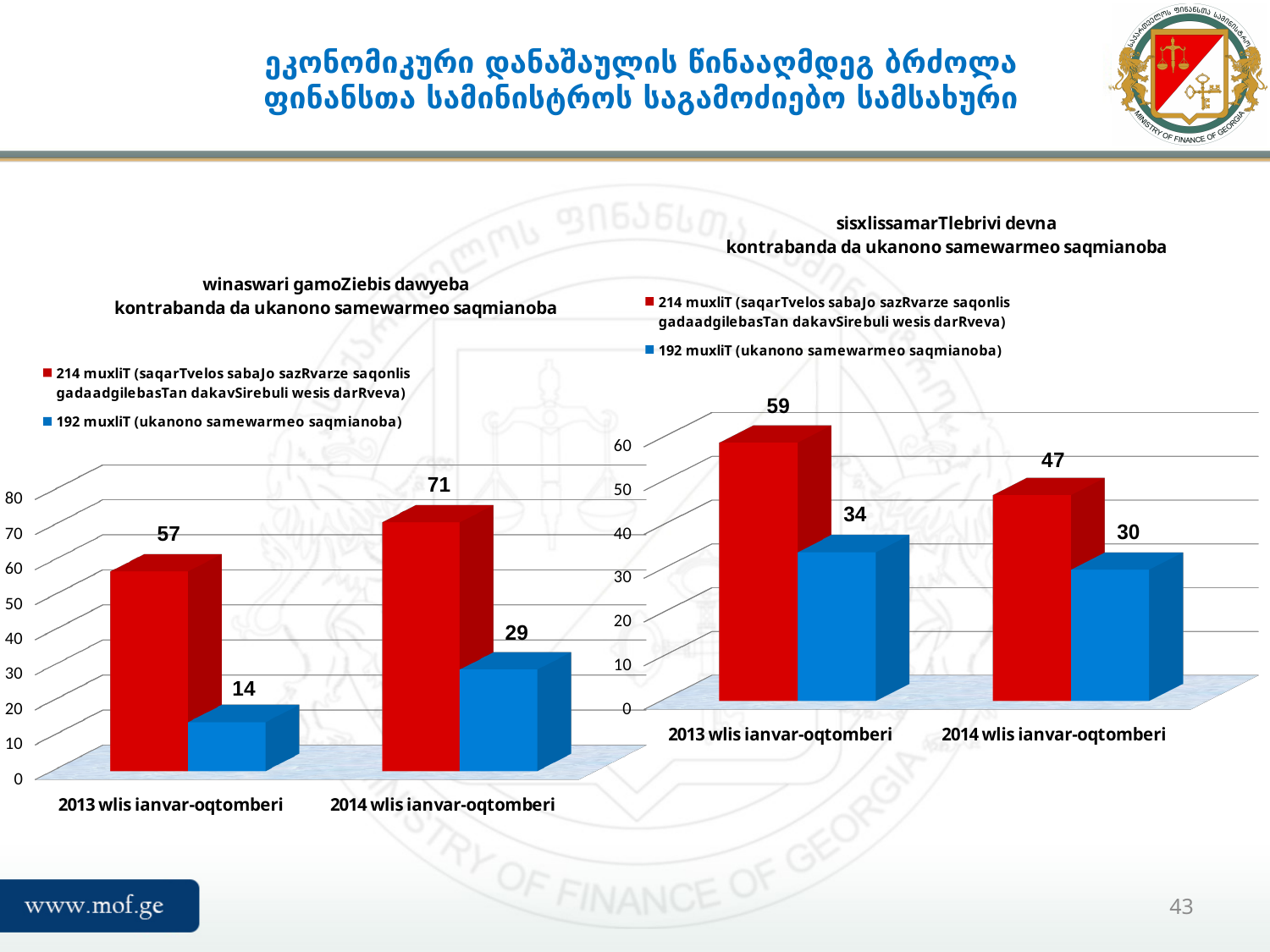
In the right chart (sisxlissamarTlebrivi devna), what is the value for 214 muxliT in 2013 wlis ianvar-oqtomberi? 59 In the right chart (sisxlissamarTlebrivi devna), what is the difference between the 214 muxliT and 192 muxliT values in 2013 wlis ianvar-oqtomberi? 25 In the left chart (winaswari gamoZiebis dawyeba), does the 192 muxliT value rise or fall from 2013 to 2014? rise What kind of chart is the left chart (winaswari gamoZiebis dawyeba)? bar chart In the right chart (sisxlissamarTlebrivi devna), what is the value for 192 muxliT in 2014 wlis ianvar-oqtomberi? 30 In the left chart (winaswari gamoZiebis dawyeba), what is the difference between the 214 muxliT values for 2014 and 2013? 14 In the left chart (winaswari gamoZiebis dawyeba), which colour represents the 192 muxliT series? blue In the right chart (sisxlissamarTlebrivi devna), does the 214 muxliT value rise or fall from 2013 to 2014? fall In the left chart (winaswari gamoZiebis dawyeba), which series has the higher value in 2013 wlis ianvar-oqtomberi? 214 muxliT How many series does the legend of the right chart (sisxlissamarTlebrivi devna) list? 2 In the left chart (winaswari gamoZiebis dawyeba), what is the value for 214 muxliT in 2013 wlis ianvar-oqtomberi? 57 In the left chart (winaswari gamoZiebis dawyeba), what is the value for 192 muxliT in 2014 wlis ianvar-oqtomberi? 29